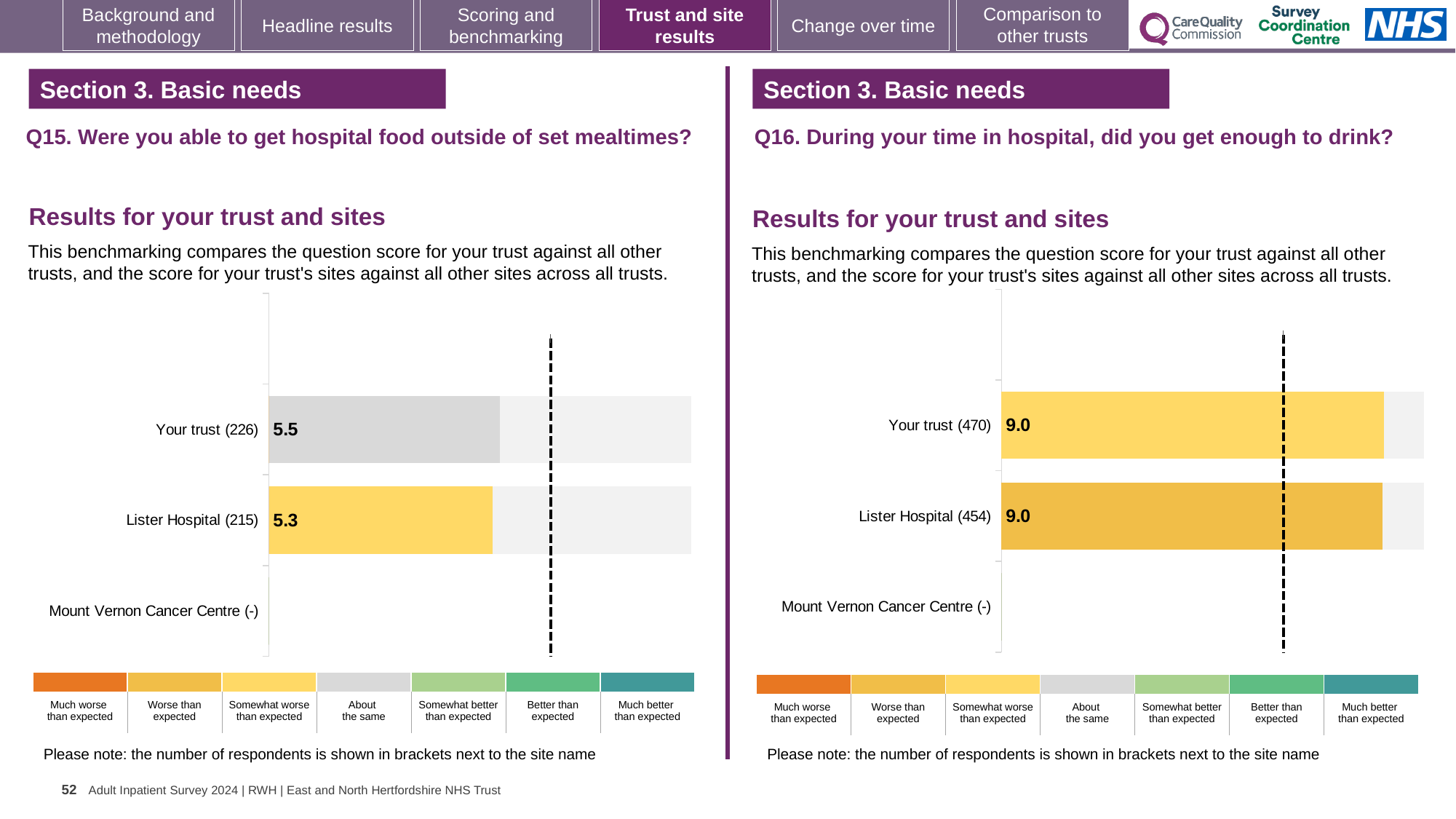
On the Q16 chart (right), what is the score for Your trust? 9.0 On the Q16 chart (right), what is the score for Lister Hospital? 9.0 On the Q16 chart (right), how many respondents are shown in brackets for Lister Hospital? 454 On the Q15 chart (left), what is the difference between the Your trust score and the Lister Hospital score? 0.2 What type of chart is used on the Q15 chart (left)? Bar chart On the Q16 chart (right), how many site/trust categories are listed on the vertical axis? 3 On the Q16 chart (right), which benchmark category does the colour of the Lister Hospital bar correspond to? Worse than expected On the Q15 chart (left), what is the score for Lister Hospital? 5.3 On the Q15 chart (left), how many respondents are shown in brackets for Your trust? 226 On the Q15 chart (left), what is the score for Your trust? 5.5 On the Q15 chart (left), which benchmark category does the colour of the Lister Hospital bar correspond to? Somewhat worse than expected On the Q15 chart (left), which has the higher score, Your trust or Lister Hospital? Your trust